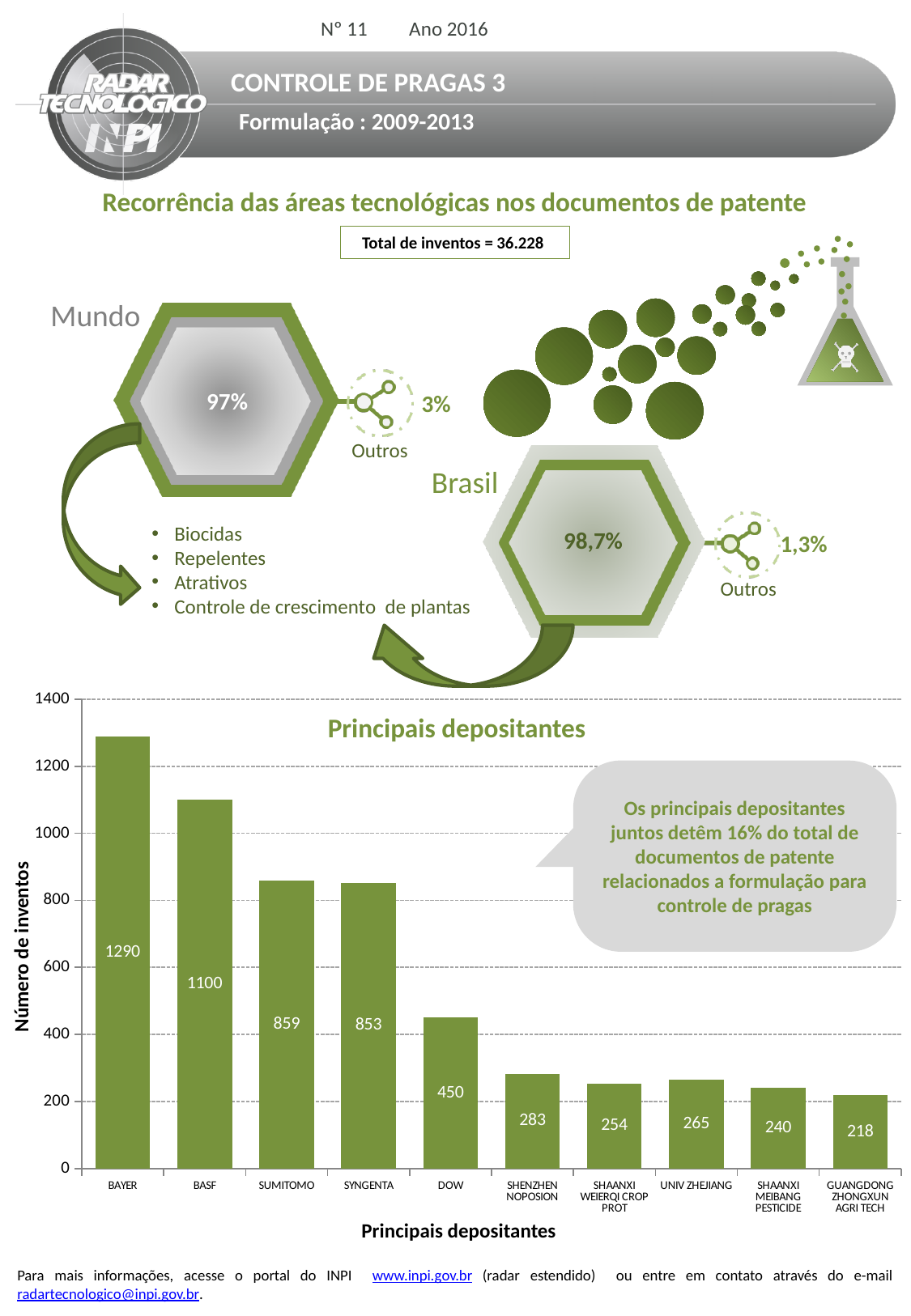
What is the label of the vertical axis in the 'Principais depositantes' chart? Número de inventos In the 'Principais depositantes' chart, what is the difference between the values for BAYER and BASF? 190 How many depositors are shown in the 'Principais depositantes' chart? 10 In the 'Principais depositantes' chart, is the value for BASF greater or less than 1000? greater In the 'Principais depositantes' chart, which depositor has the lowest number of inventions? GUANGDONG ZHONGXUN AGRI TECH In the 'Principais depositantes' chart, what is the difference between the values for SUMITOMO and SYNGENTA? 6 In the 'Principais depositantes' chart, which has a larger value, SHENZHEN NOPOSION or SHAANXI MEIBANG PESTICIDE? SHENZHEN NOPOSION In the 'Principais depositantes' chart, what is the number of inventions for BAYER? 1290 What type of chart is 'Principais depositantes'? Bar chart In the 'Principais depositantes' chart, what is the value for UNIV ZHEJIANG? 265 In the 'Principais depositantes' chart, what is the value for DOW? 450 In the 'Principais depositantes' chart, which depositor has the highest number of inventions? BAYER